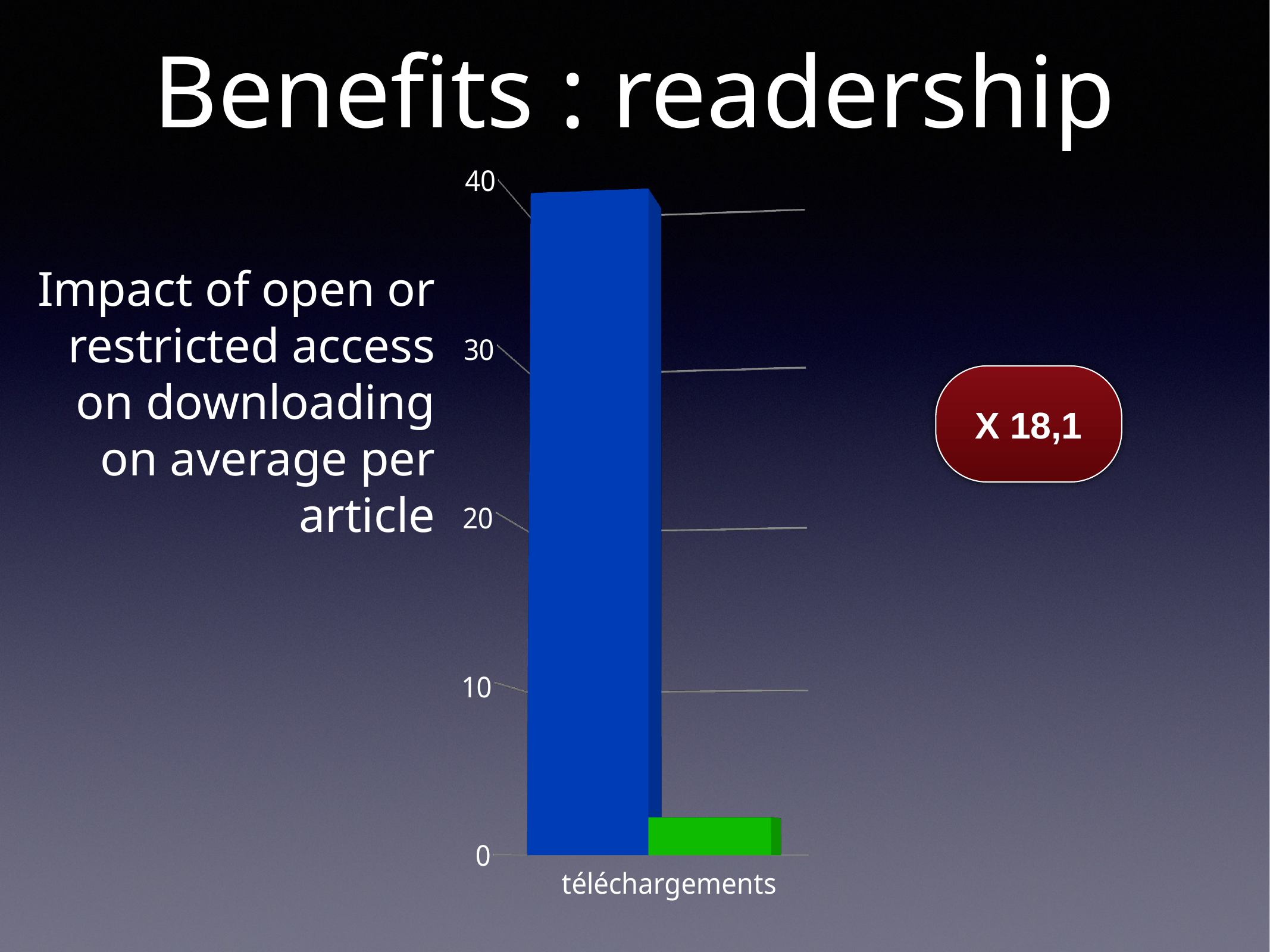
Is the value of the green bar greater or less than 10? less Is the value of the blue bar greater or less than 20? greater How many categories are shown on the x axis of the chart? 1 What is the highest value shown on the vertical axis of the chart? 40 Which bar is the lowest in the chart? the green bar What is the category label shown on the x axis of the chart? téléchargements What kind of chart is shown on the slide? bar chart Which bar is the highest in the chart? the blue bar Is the value of the blue bar greater or less than 30? greater Which bar is taller in the chart, the blue bar or the green bar? the blue bar How many bars are plotted in the chart? 2